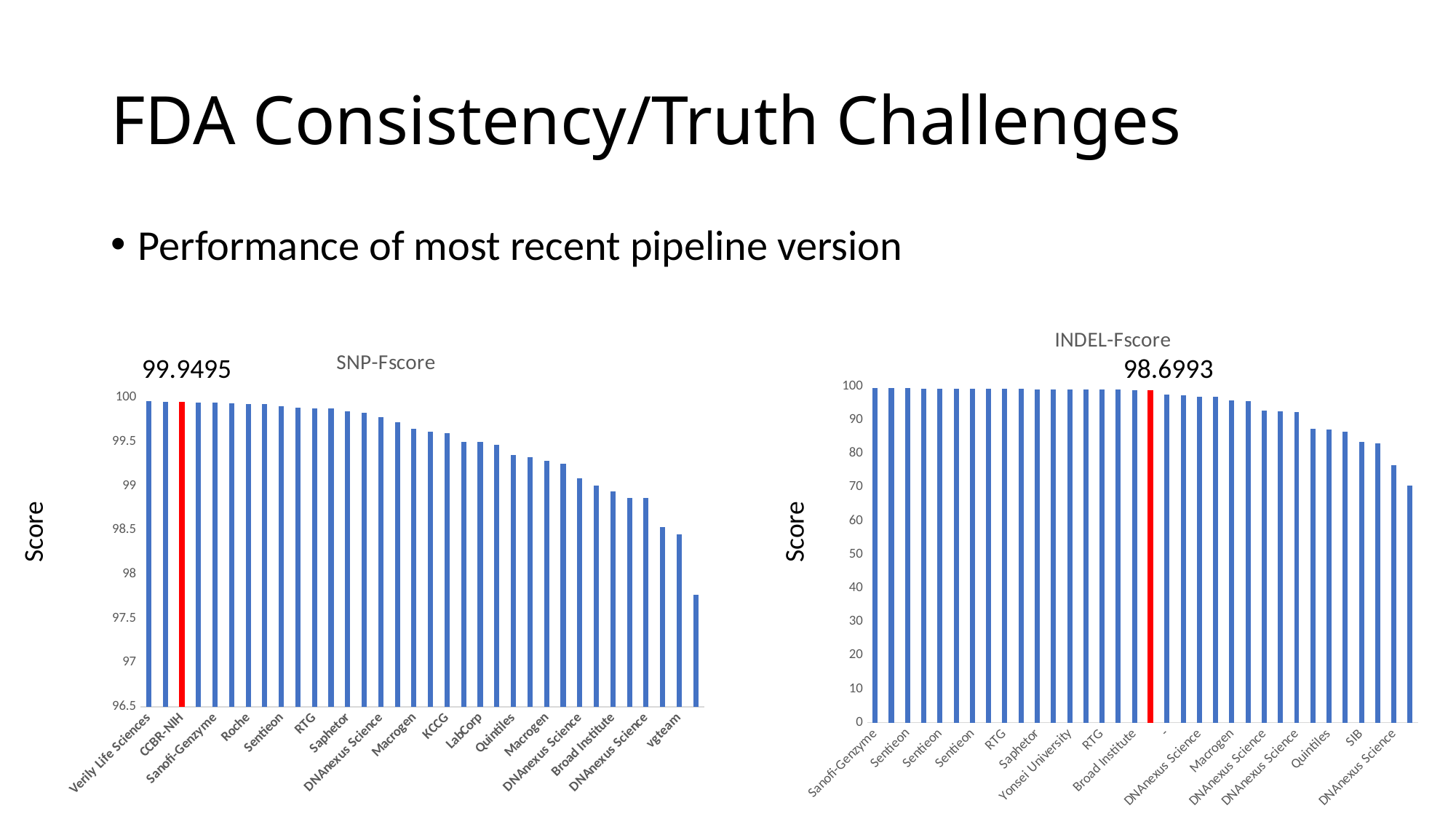
In the INDEL-Fscore chart, do the values rise or fall from left to right along the x axis? fall In the SNP-Fscore chart, what value is labelled on the highlighted red bar (CCBR-NIH)? 99.9495 In the INDEL-Fscore chart, what value is labelled on the highlighted red bar? 98.6993 What is the y-axis title of the INDEL-Fscore chart? Score What is the difference between the labelled red-bar value in the SNP-Fscore chart and the labelled red-bar value in the INDEL-Fscore chart? 1.2502 In the SNP-Fscore chart, is the value for Verily Life Sciences greater or less than 99.5? greater In the INDEL-Fscore chart, is the value for Quintiles greater or less than 80? greater In the SNP-Fscore chart, which is larger, the value for Verily Life Sciences or the value for vgteam? Verily Life Sciences In the SNP-Fscore chart, is the lowest bar greater or less than 98? less What kind of chart is the SNP-Fscore chart on the left? bar chart In the INDEL-Fscore chart, which is larger, the value for Sanofi-Genzyme or the value for Quintiles? Sanofi-Genzyme In the SNP-Fscore chart, do the values rise or fall from left to right along the x axis? fall